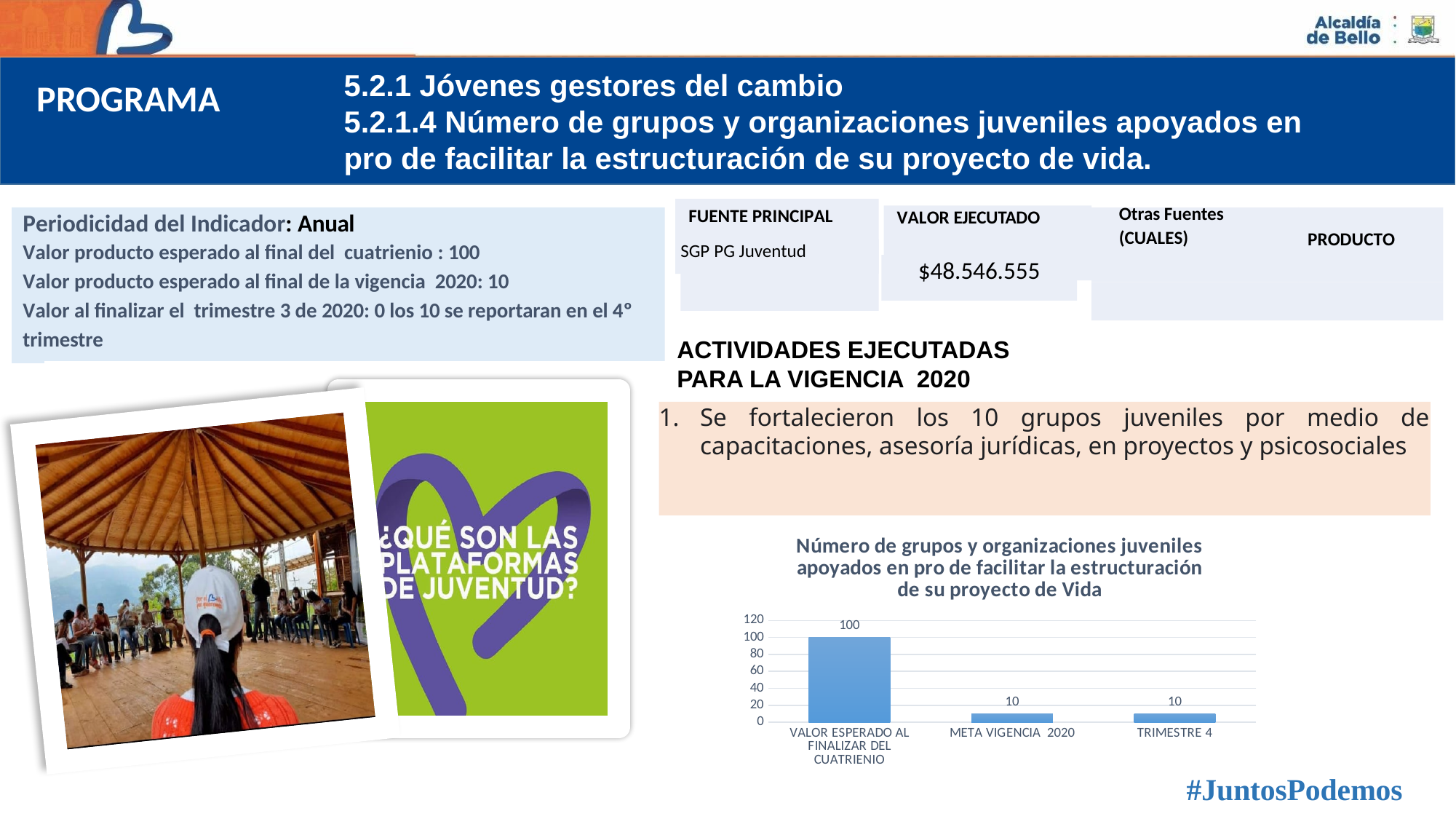
What kind of chart is shown on the slide? bar chart What is the value for META VIGENCIA 2020? 10 Is the value for VALOR ESPERADO AL FINALIZAR DEL CUATRIENIO greater or less than 80? greater Which category has the highest value? VALOR ESPERADO AL FINALIZAR DEL CUATRIENIO Do the values for META VIGENCIA 2020 and TRIMESTRE 4 differ? No, both are 10 Is the value for META VIGENCIA 2020 greater or less than 40? less How many categories are shown on the chart? 3 What is the value for TRIMESTRE 4? 10 What is the value for VALOR ESPERADO AL FINALIZAR DEL CUATRIENIO? 100 What is the difference between the value for VALOR ESPERADO AL FINALIZAR DEL CUATRIENIO and the value for META VIGENCIA 2020? 90 Which is larger, the value for VALOR ESPERADO AL FINALIZAR DEL CUATRIENIO or the value for TRIMESTRE 4? VALOR ESPERADO AL FINALIZAR DEL CUATRIENIO What is the maximum value shown on the vertical axis of the chart? 120